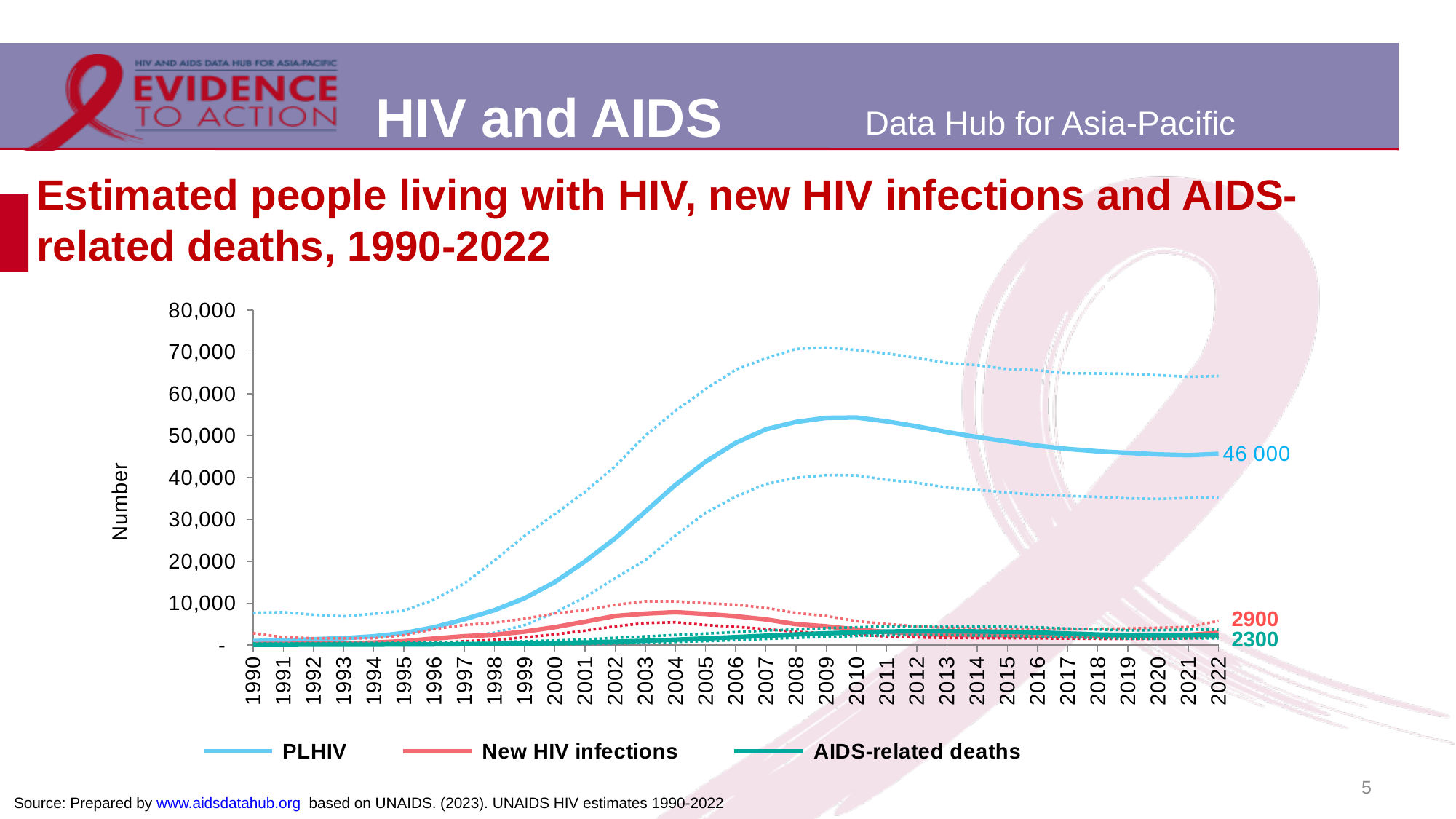
Does the PLHIV line rise or fall between 2010 and 2022? Fall In 2022, which is larger: the value for New HIV infections or the value for AIDS-related deaths? New HIV infections What is the labelled value for PLHIV in 2022? 46 000 What is the labelled value for New HIV infections in 2022? 2900 What kind of chart is shown on the slide? Line chart What is the label on the vertical axis of the chart? Number What is the labelled value for AIDS-related deaths in 2022? 2300 Is the value for PLHIV in 2010 greater or less than 50,000? greater How many series does the legend list? 3 What is the difference between the 2022 values for New HIV infections and AIDS-related deaths? 600 Is the value for PLHIV in 2000 greater or less than 20,000? less Which series has the highest value in 2022? PLHIV